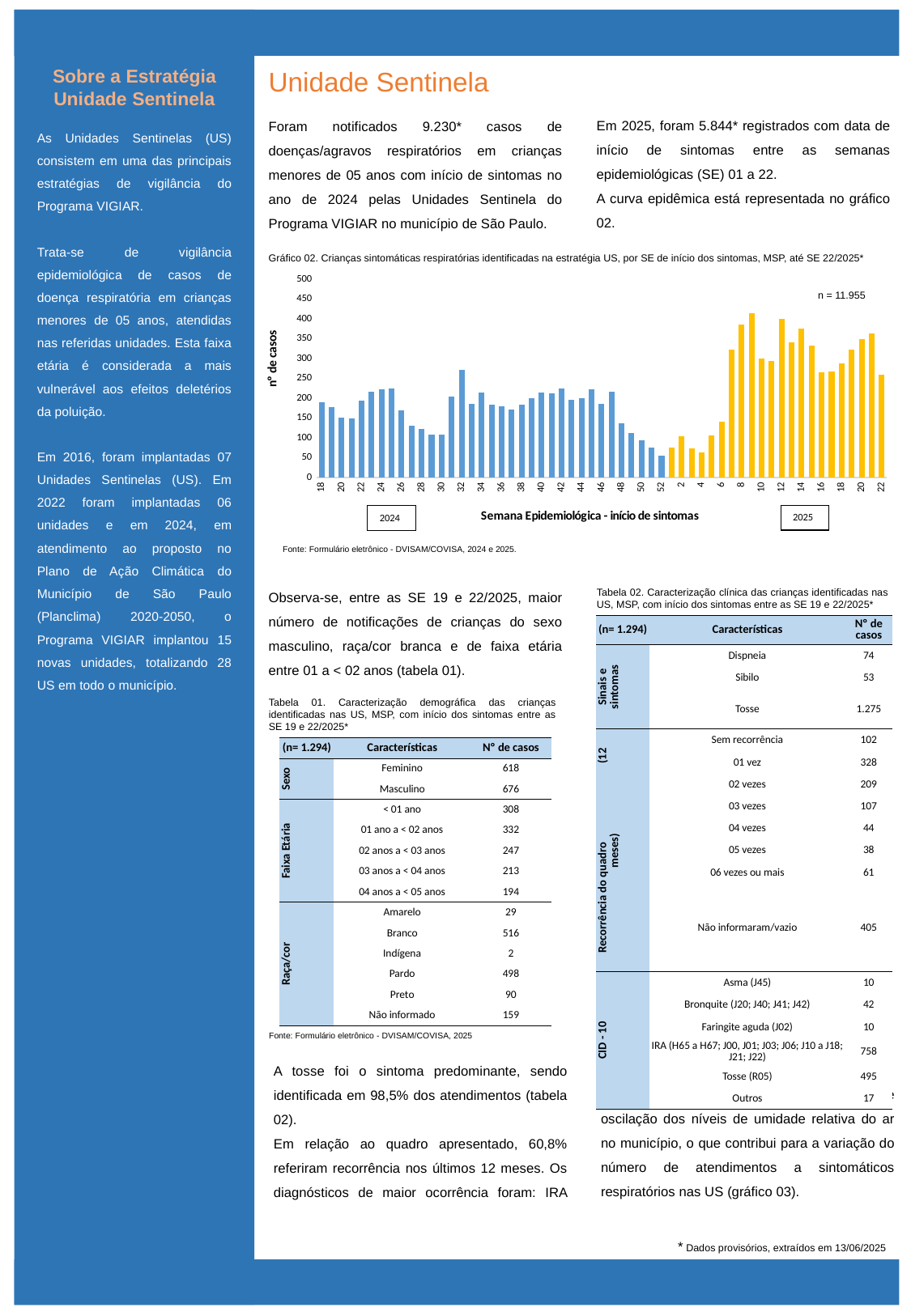
In Gráfico 02, is the value for SE 22 of 2025 greater or less than 200? greater In Gráfico 02, what is the total number of cases (n) shown in the chart annotation? n = 11.955 In Gráfico 02, do the values rise or fall from SE 46 to SE 52 of 2024? fall In Gráfico 02, which is larger: the value for SE 10 of 2025 or SE 18 of 2024? SE 10 of 2025 In Gráfico 02, which is larger: the value for SE 32 of 2024 or SE 30 of 2024? SE 32 of 2024 In Gráfico 02, what is the label of the y axis? nº de casos In Gráfico 02, which two years are shown on the x axis? 2024 and 2025 In Gráfico 02, is the value for SE 32 of 2024 greater or less than 250? greater What type of chart is Gráfico 02? bar chart In Gráfico 02, do the values rise or fall from SE 2 to SE 10 of 2025? rise In Gráfico 02, is the value for SE 10 of 2025 greater or less than 350? less